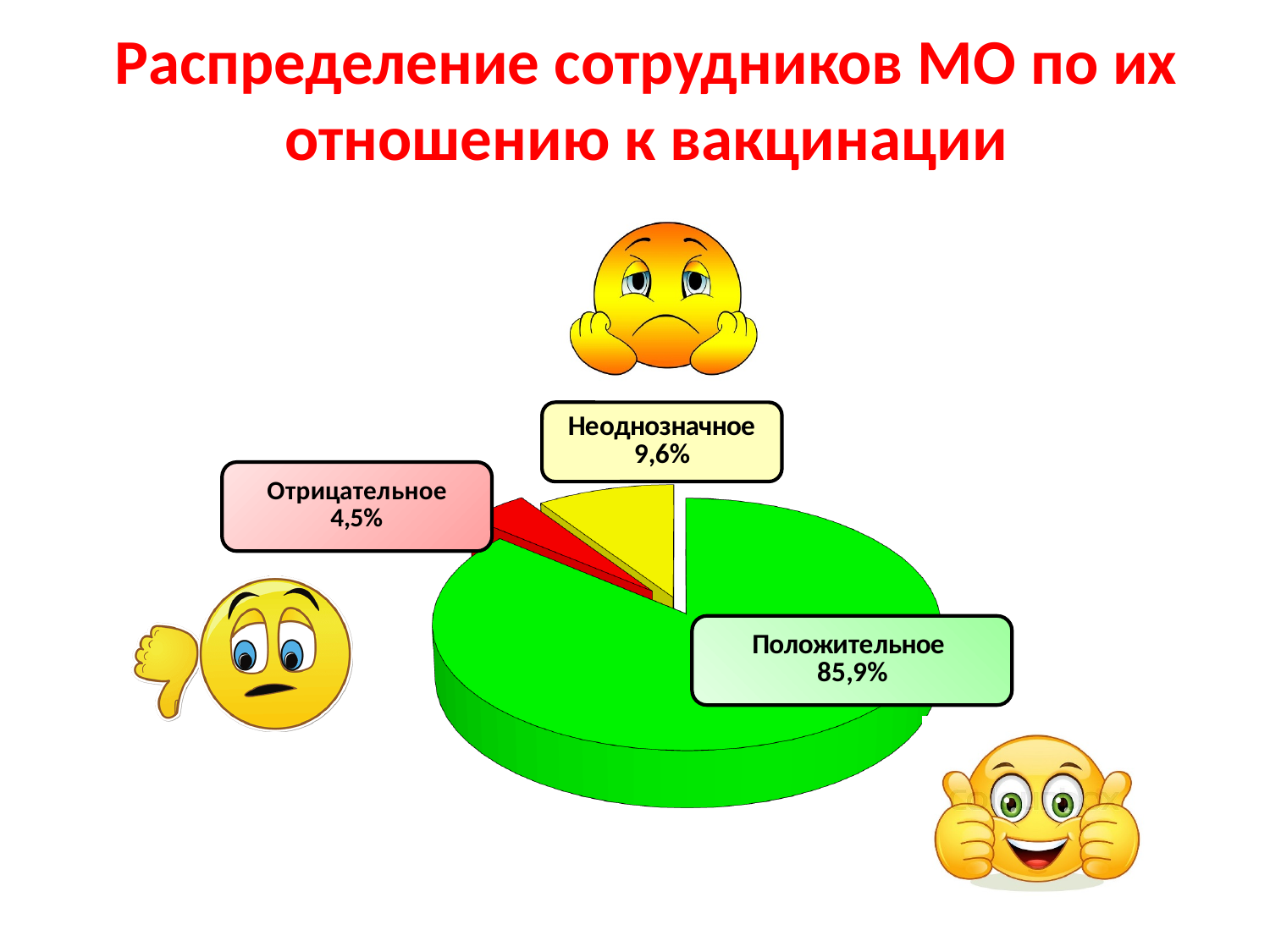
Which is larger, the share for Неоднозначное or the share for Отрицательное? Неоднозначное What kind of chart is shown on the slide? pie chart What share of employees have a positive (Положительное) attitude to vaccination? 85,9% What is the title of the chart on the slide? Распределение сотрудников МО по их отношению к вакцинации What share of employees have an ambiguous (Неоднозначное) attitude to vaccination? 9,6% What colour is the slice for Положительное? green What is the difference in percentage points between the Положительное and Неоднозначное shares? 76,3 What share of employees have a negative (Отрицательное) attitude to vaccination? 4,5% What is the difference in percentage points between the Неоднозначное and Отрицательное shares? 5,1 Which category has the smallest share of the pie? Отрицательное How many categories are shown in the pie chart? 3 Which category has the largest share of the pie? Положительное